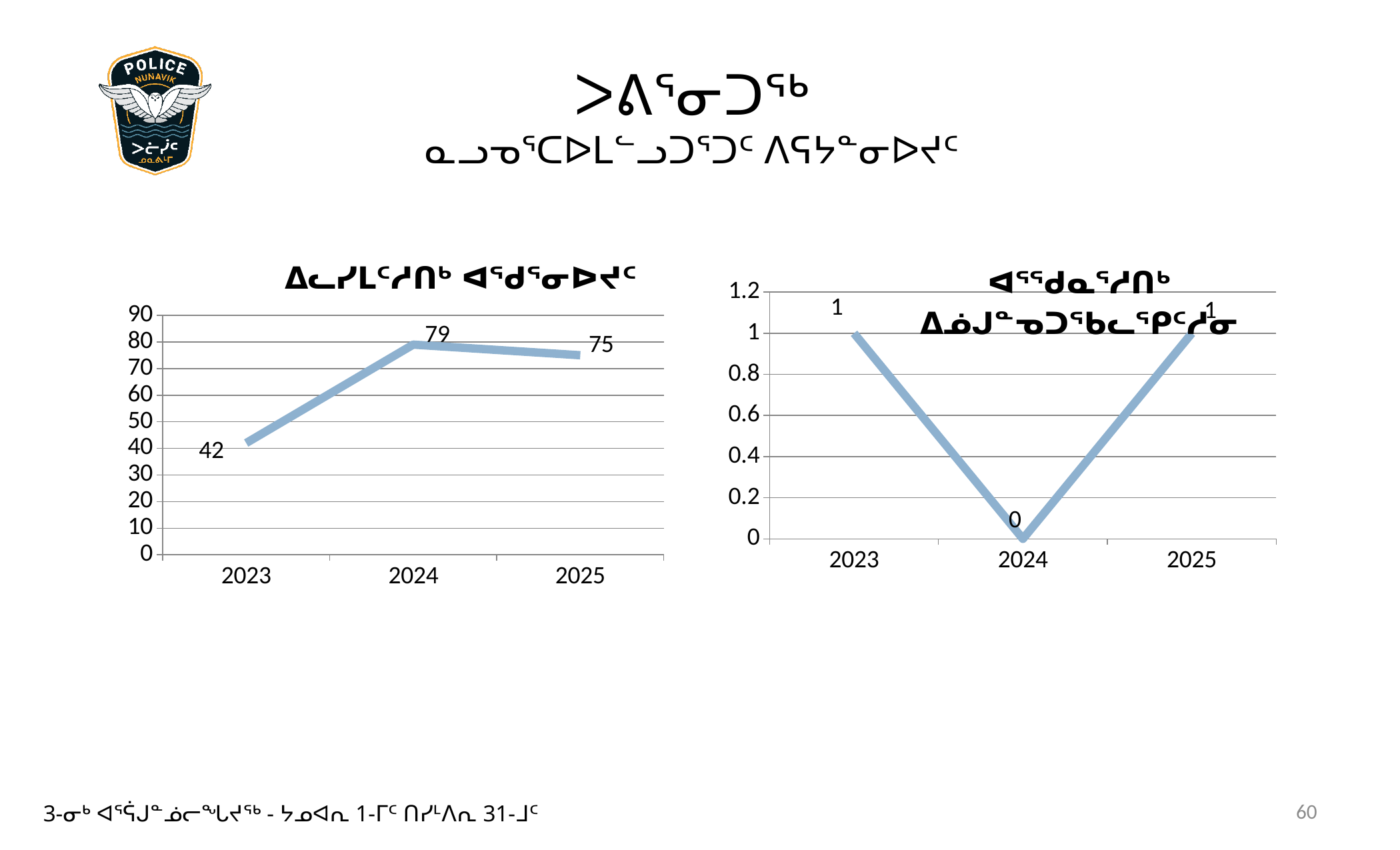
In the left chart, what is the value for 2025? 75 In the left chart, what is the value for 2023? 42 In the left chart, is the value for 2025 greater or less than 70? greater How many years are plotted on the x axis of the right chart? 3 In the right chart, what is the value for 2024? 0 In the left chart, what is the difference between the values for 2024 and 2023? 37 In the right chart, what is the value for 2023? 1 In the right chart, which year has the lowest value? 2024 In the left chart, what is the value for 2024? 79 In the left chart, which year has the highest value? 2024 In the left chart, which year has the lowest value? 2023 What kind of chart is the left chart? line chart